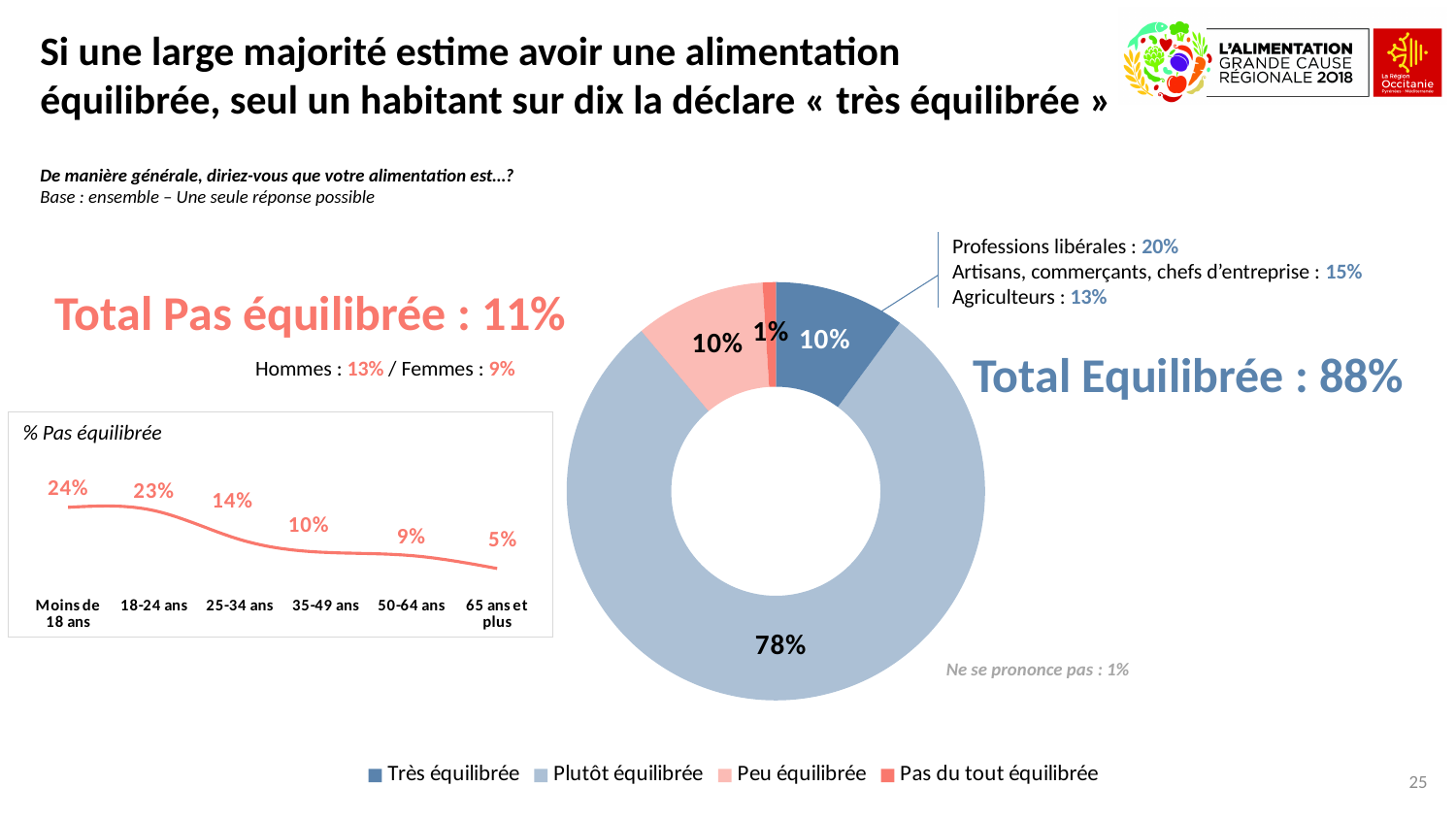
In the donut chart, which category has the smallest share? Pas du tout équilibrée In the donut chart, what share of respondents say their diet is "Très équilibrée"? 10% In the "% Pas équilibrée" line chart, which age group has the lowest value? 65 ans et plus In the "% Pas équilibrée" line chart, what is the value for "65 ans et plus"? 5% How many categories does the legend of the donut chart list? 4 How many age groups are shown on the x axis of the "% Pas équilibrée" line chart? 6 In the donut chart, what share of respondents say their diet is "Pas du tout équilibrée"? 1% In the donut chart, what share of respondents say their diet is "Plutôt équilibrée"? 78% In the "% Pas équilibrée" line chart, what is the difference between the values for "18-24 ans" and "25-34 ans"? 9% In the donut chart, which category has the largest share? Plutôt équilibrée In the "% Pas équilibrée" line chart, what is the value for "Moins de 18 ans"? 24% In the "% Pas équilibrée" line chart, do the values rise or fall as age increases along the x axis? fall